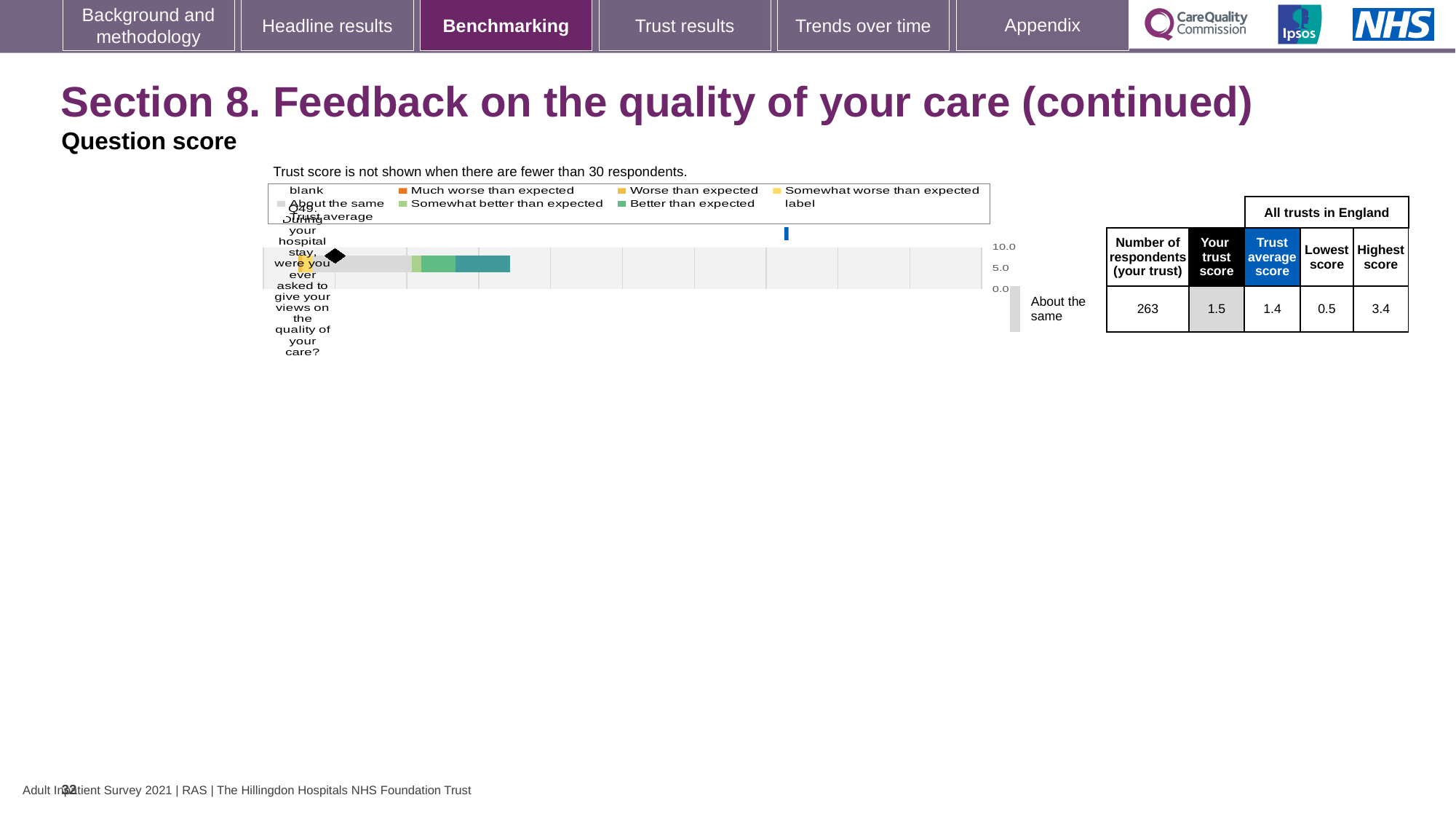
Which is larger for Q49, the trust's own score or the trust average score? Your trust score What is the trust's score for Q49 (Your trust score)? 1.5 What is the difference between the highest and lowest scores for Q49 across all trusts in England? 2.9 Which question number is shown in the benchmarking chart? Q49 Which benchmark category is the trust's Q49 result placed in? About the same What is the lowest score for Q49 among all trusts in England? 0.5 What is the highest score for Q49 among all trusts in England? 3.4 How many entries does the chart legend list? 9 How many questions are plotted in the benchmarking chart? 1 How many respondents from the trust answered Q49? 263 What is the trust average score for Q49 across all trusts in England? 1.4 What kind of chart is used to show the Q49 benchmarking result? bar chart